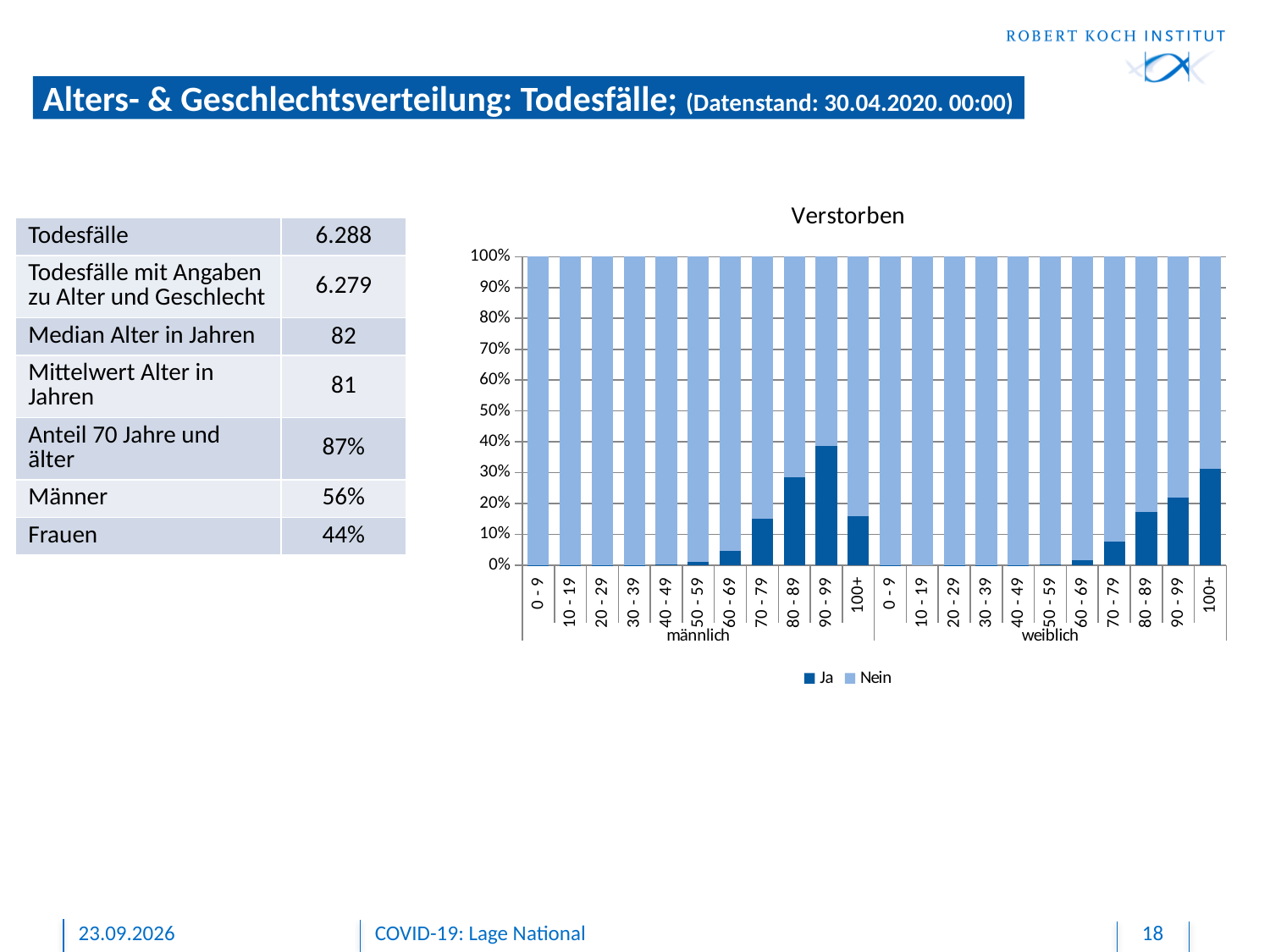
Is the 'Ja' share for männlich 90 - 99 greater or less than 30%? greater What are the two series named in the legend? Ja and Nein Is the 'Ja' share for weiblich 70 - 79 greater or less than 10%? less Which has the larger 'Ja' share: männlich 90 - 99 or weiblich 90 - 99? männlich 90 - 99 What kind of chart is shown on the slide? Stacked bar chart Is the 'Ja' share for männlich 80 - 89 greater or less than 30%? less How many bars (age-group categories) are plotted in the chart in total? 22 Which bar has the largest 'Ja' share in the chart? männlich 90 - 99 What is the title of the chart? Verstorben Which has the larger 'Ja' share: männlich 100+ or weiblich 100+? weiblich 100+ How many series does the chart legend list? 2